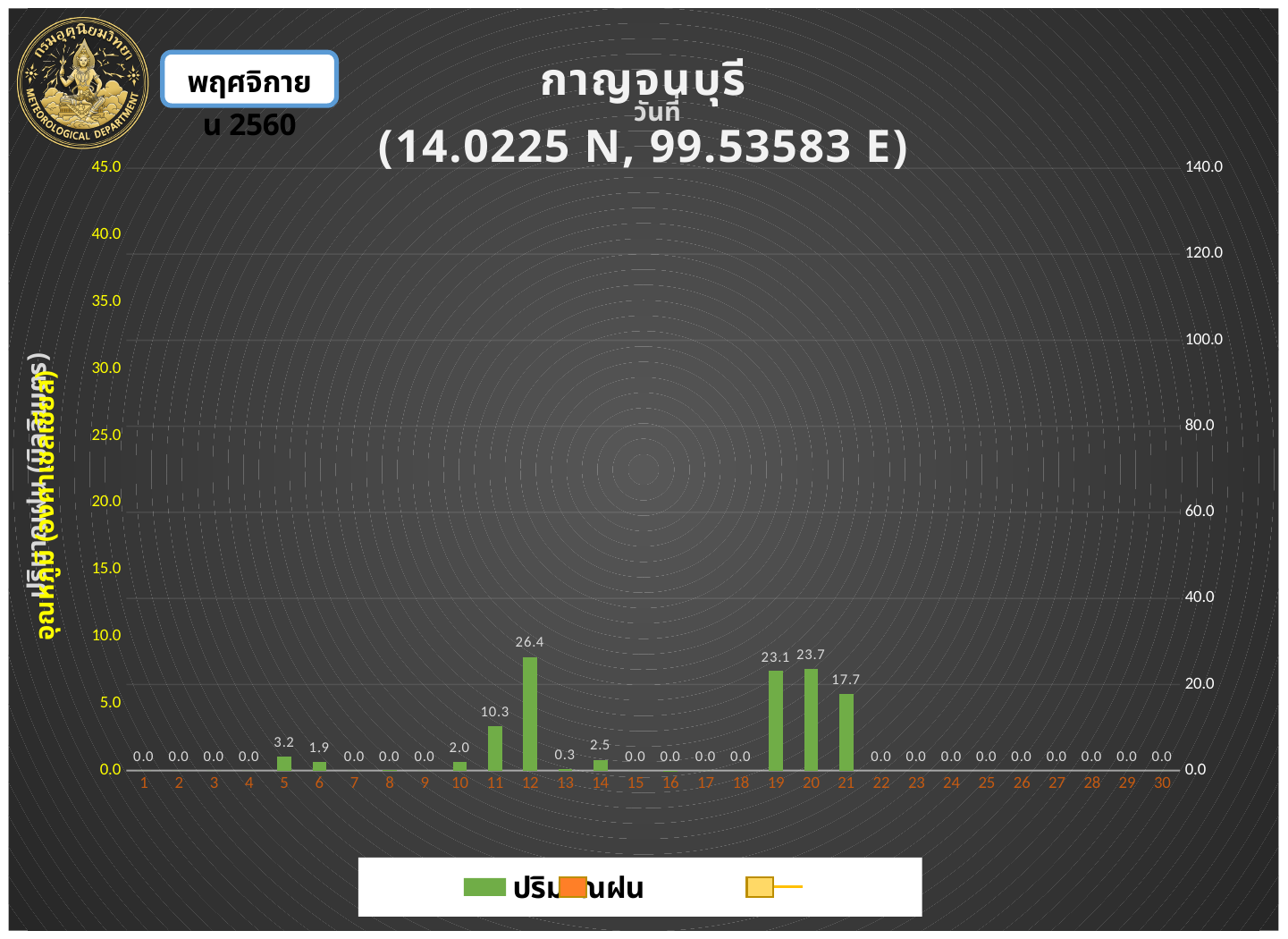
What is the rainfall value shown for day 19? 23.1 What is the difference between the rainfall values for day 12 and day 20? 2.7 Which has a larger rainfall value, day 20 or day 19? day 20 Which day has the highest rainfall value? 12 What kind of chart is shown on the slide? bar chart Which has a larger rainfall value, day 11 or day 21? day 21 What is the rainfall value shown for day 5? 3.2 What is the rainfall value shown for day 12? 26.4 How many days are shown on the x axis? 30 What is the difference between the rainfall values for day 20 and day 19? 0.6 What is the rainfall value shown for day 21? 17.7 What is the rainfall value shown for day 11? 10.3